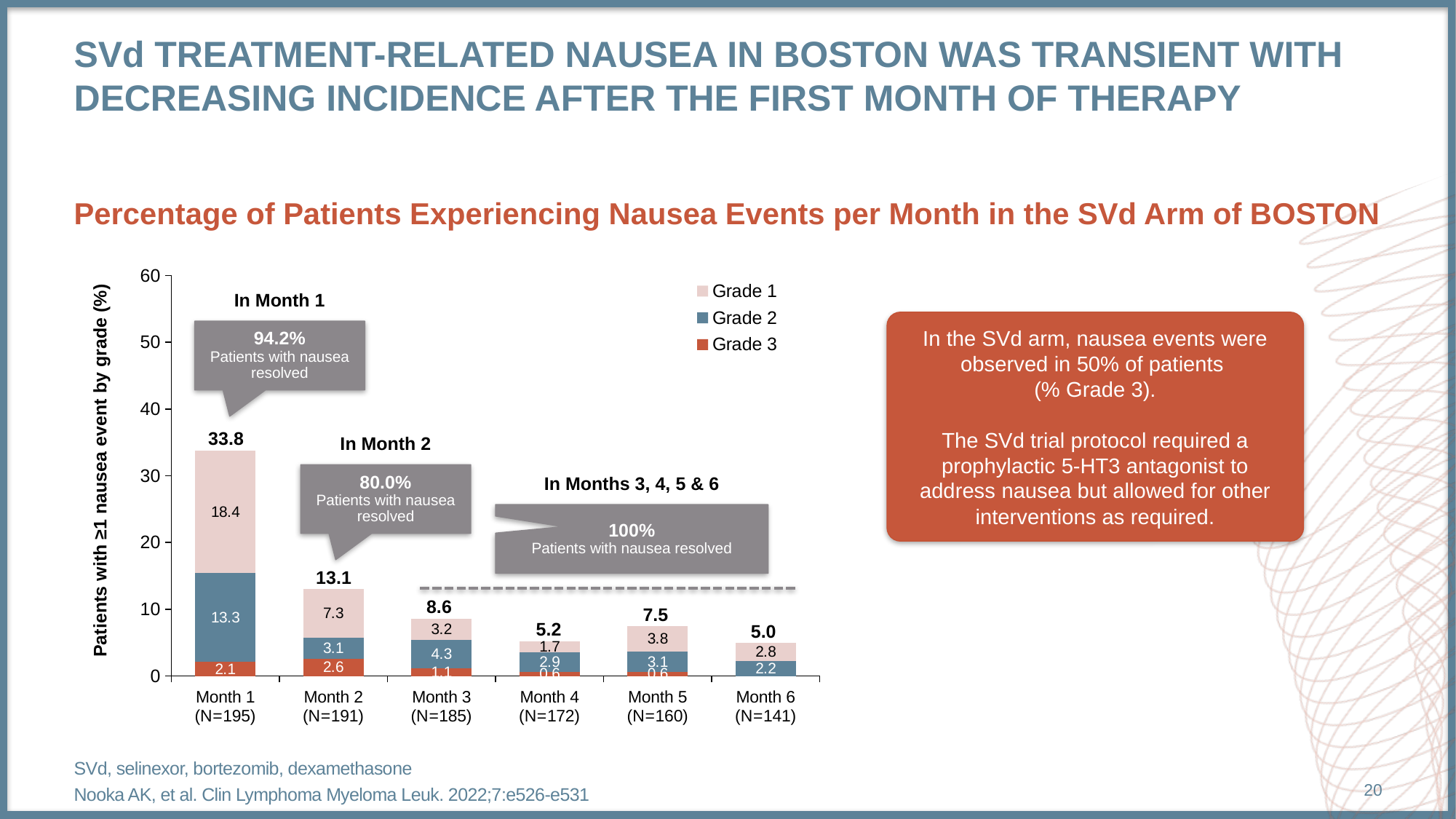
How many months are shown on the x axis? 6 Which is larger, the Grade 3 value for Month 1 or the Grade 3 value for Month 2? Month 2 How many series does the legend list? 3 Which month has the highest total percentage of patients with a nausea event? Month 1 Which month has the lowest total percentage of patients with a nausea event? Month 6 What is the difference between the total values for Month 1 and Month 2? 20.7 What is the Grade 1 value for Month 2? 7.3 What is the Grade 2 value for Month 3? 4.3 What percentage of patients with nausea had it resolved in Month 1, according to the callout? 94.2% Is the total value for Month 1 greater or less than 30? greater What is the total percentage of patients with at least one nausea event in Month 1? 33.8 What kind of chart is shown on the slide? Stacked bar chart